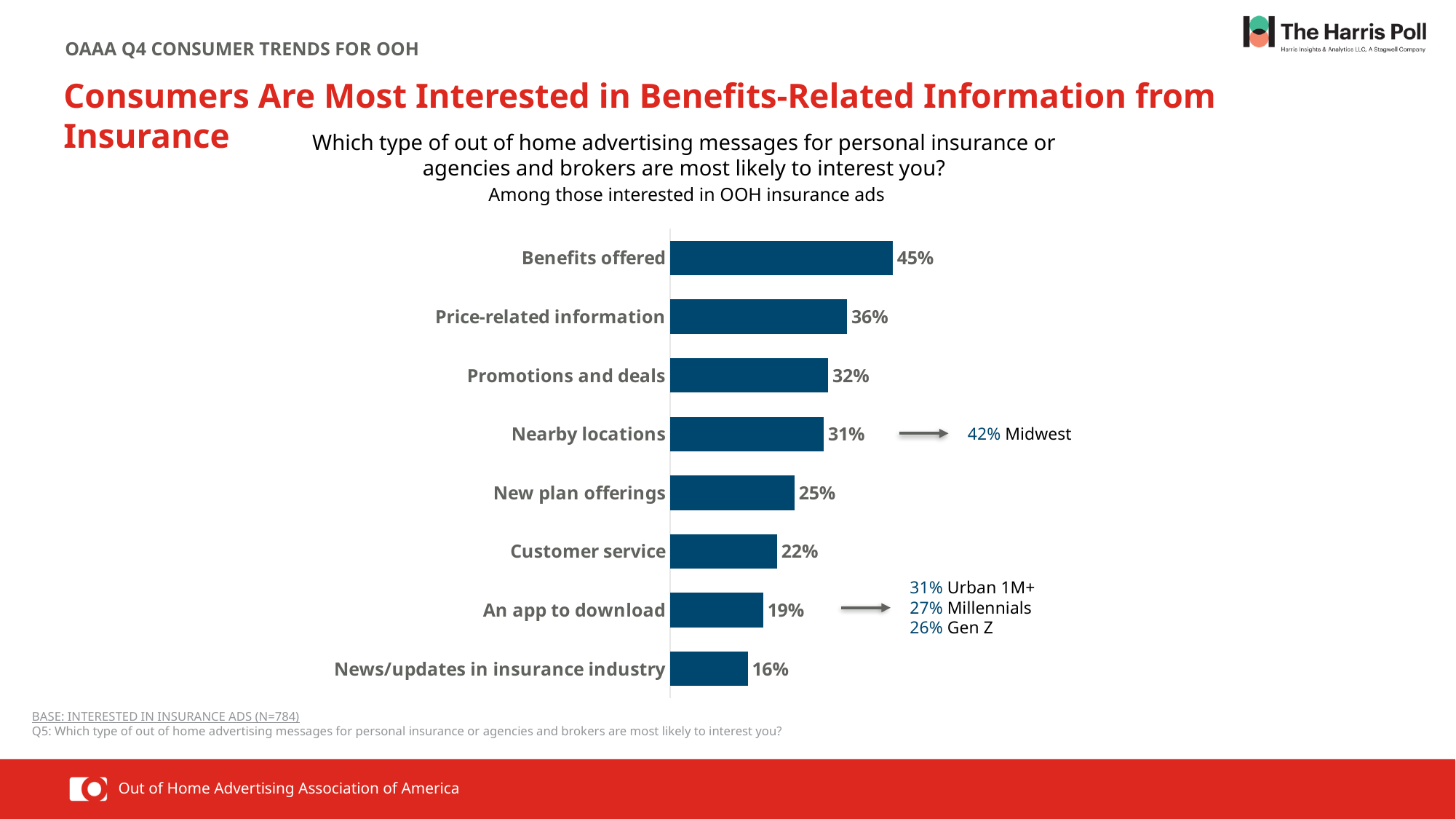
Which has a higher value, 'Promotions and deals' or 'Customer service'? Promotions and deals According to the callout next to 'An app to download', what is the value for Millennials? 27% What is the difference between the values for 'Benefits offered' and 'Price-related information'? 9% What kind of chart is shown on the slide? Bar chart Which category has the lowest value in the chart? News/updates in insurance industry How many categories are shown in the chart? 8 What is the value shown for 'Customer service'? 22% According to the callout next to 'Nearby locations', what is the value for the Midwest? 42% What is the value shown for 'News/updates in insurance industry'? 16% What is the difference between the values for 'New plan offerings' and 'An app to download'? 6% Which category has the highest value in the chart? Benefits offered What percentage of respondents are most interested in 'Benefits offered' messages? 45%